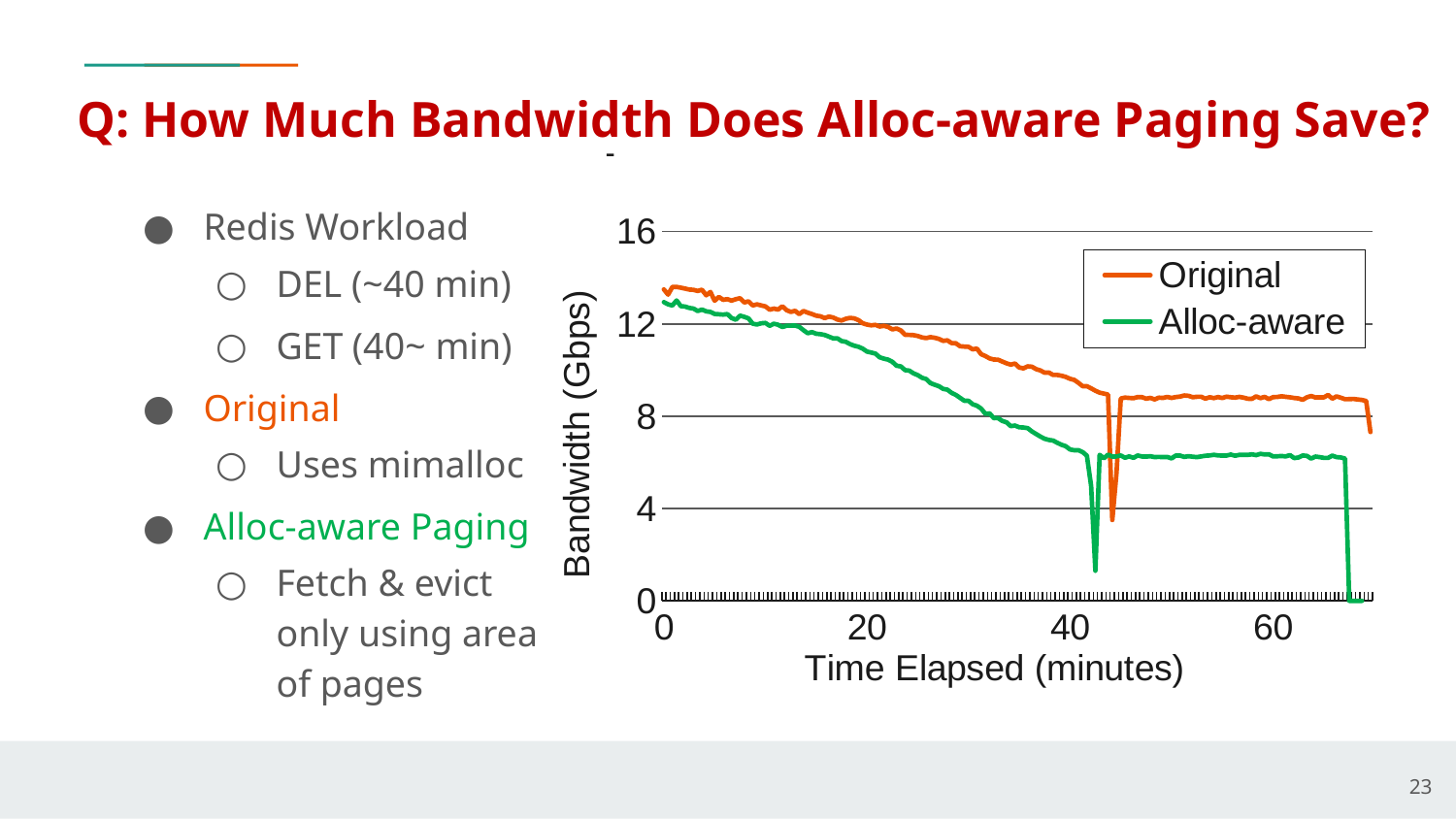
At 60 minutes, which series has the higher bandwidth, Original or Alloc-aware? Original What are the two series named in the chart's legend? Original and Alloc-aware Is the bandwidth for Alloc-aware at 20 minutes greater or less than 12? less Is the bandwidth for Alloc-aware at 60 minutes greater or less than 8? less Does the Alloc-aware series rise or fall between 0 and 40 minutes? fall What kind of chart is shown on the slide? line chart Is the bandwidth for Original at 0 minutes greater or less than 12? greater How many series does the chart's legend list? 2 Does the Original series rise or fall between 0 and 40 minutes? fall What is the label of the chart's y axis? Bandwidth (Gbps)